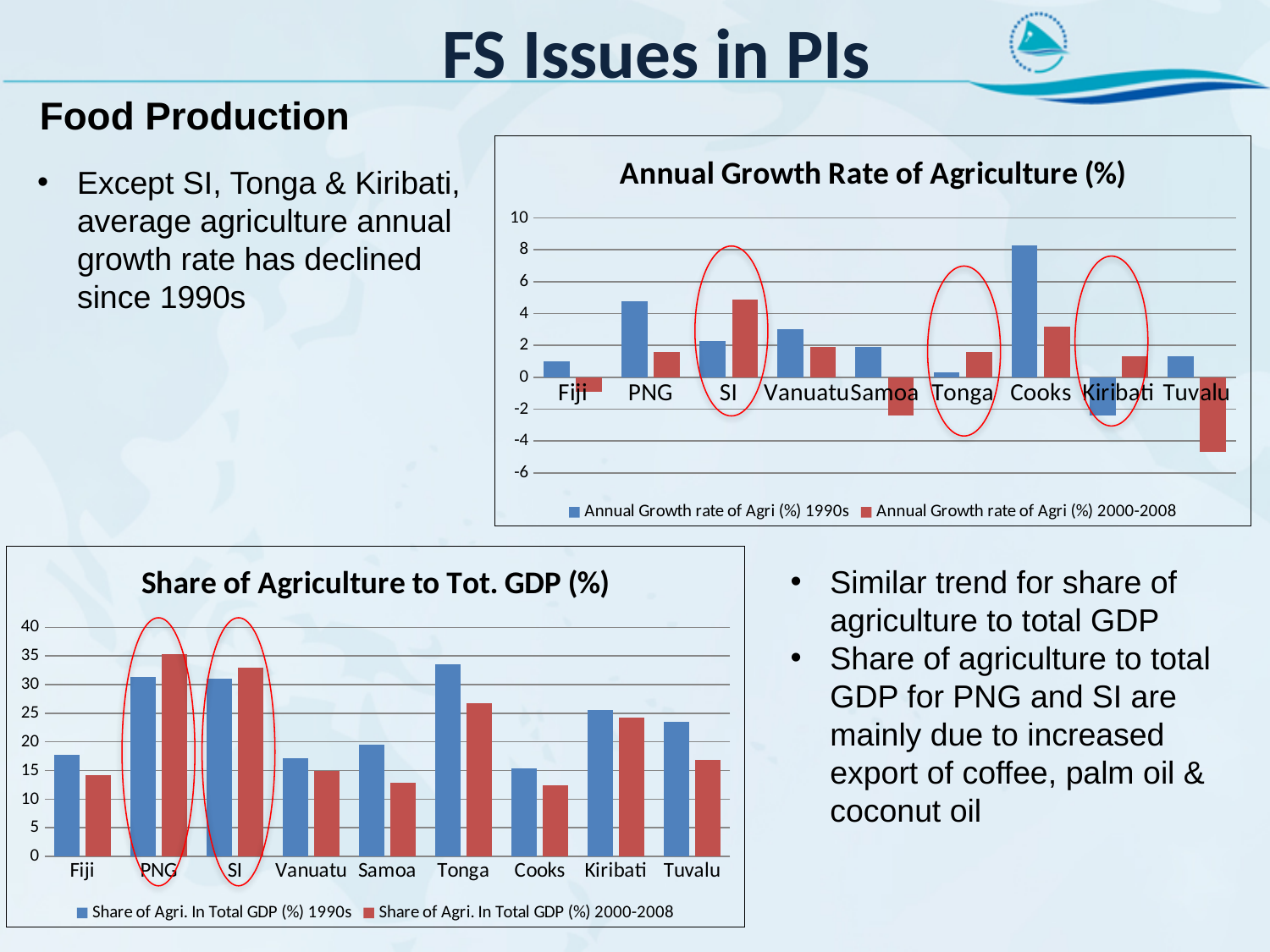
In the 'Share of Agriculture to Tot. GDP (%)' chart, which country has the highest 1990s share? Tonga In the 'Annual Growth Rate of Agriculture (%)' chart, which is larger for SI: the 1990s value or the 2000-2008 value? 2000-2008 What type of chart is the 'Annual Growth Rate of Agriculture (%)' chart? bar chart How many countries are shown on the x axis of the 'Annual Growth Rate of Agriculture (%)' chart? 9 In the 'Annual Growth Rate of Agriculture (%)' chart, which country has the highest 1990s growth rate? Cooks In the 'Share of Agriculture to Tot. GDP (%)' chart, is the 1990s value for Tonga greater or less than 30? greater In the 'Annual Growth Rate of Agriculture (%)' chart, which country has the lowest 2000-2008 growth rate? Tuvalu In the 'Annual Growth Rate of Agriculture (%)' chart, is the 1990s value for Cooks greater or less than 6? greater In the 'Annual Growth Rate of Agriculture (%)' chart, is the 2000-2008 value for Tuvalu greater or less than -2? less How many series does the legend of the 'Annual Growth Rate of Agriculture (%)' chart list? 2 What colour are the bars for the 2000-2008 series in the 'Share of Agriculture to Tot. GDP (%)' chart? red In the 'Share of Agriculture to Tot. GDP (%)' chart, which country has the highest 2000-2008 share? PNG